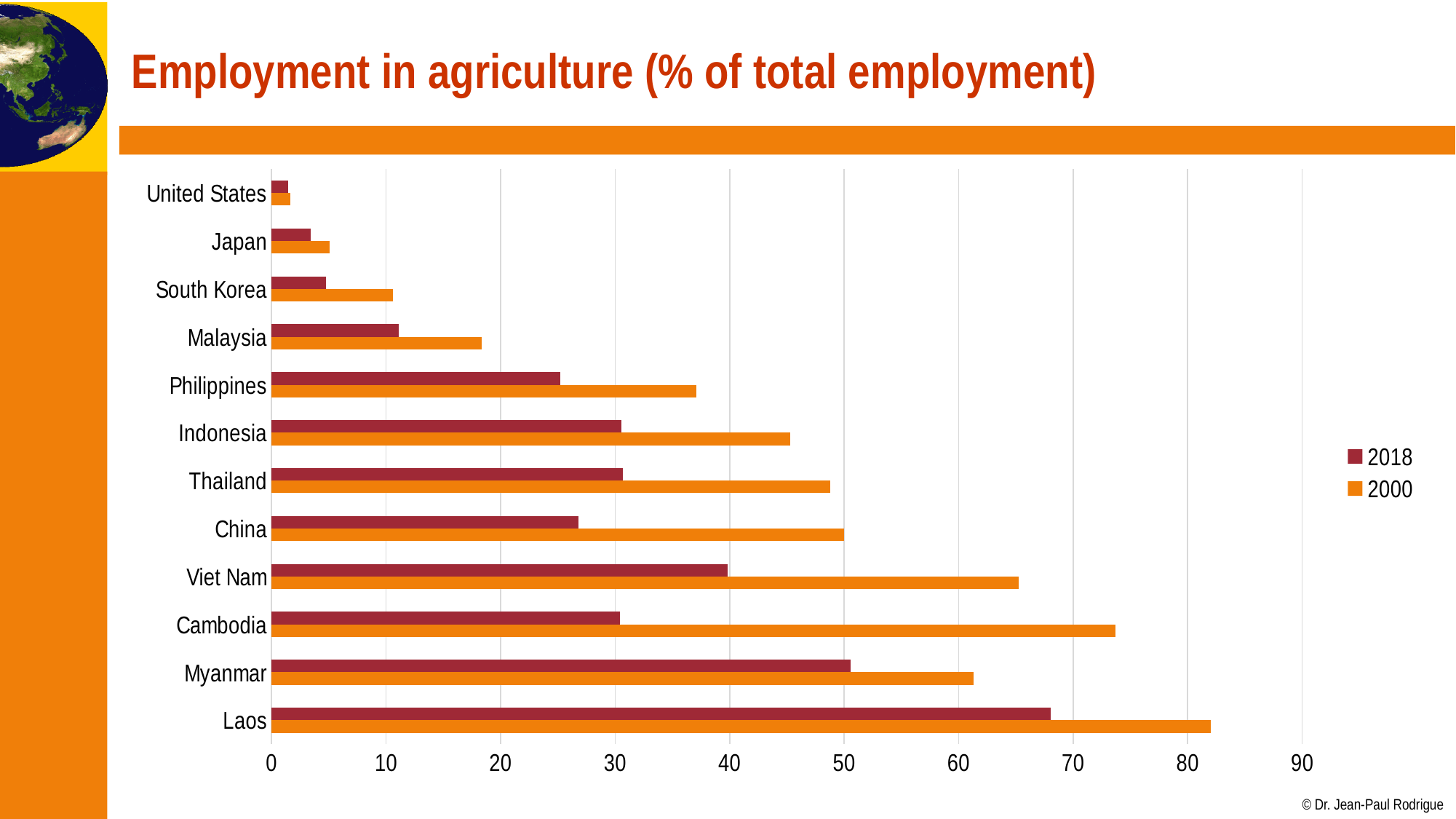
Is the 2000 value for Cambodia greater or less than 70? greater Which country has the highest value for 2018? Laos How many series does the legend list? 2 How many countries are listed on the chart? 12 Which country has the lowest value for 2000? United States Is the 2000 value for Indonesia greater or less than 40? greater Which country has the highest value for 2000? Laos Which is larger, the 2000 value for Cambodia or the 2000 value for Viet Nam? Cambodia Which is larger, the 2018 value for Myanmar or the 2018 value for Viet Nam? Myanmar What kind of chart is shown on the slide? Bar chart Is the 2000 value for Malaysia greater or less than 20? less What are the two years listed in the legend? 2018 and 2000